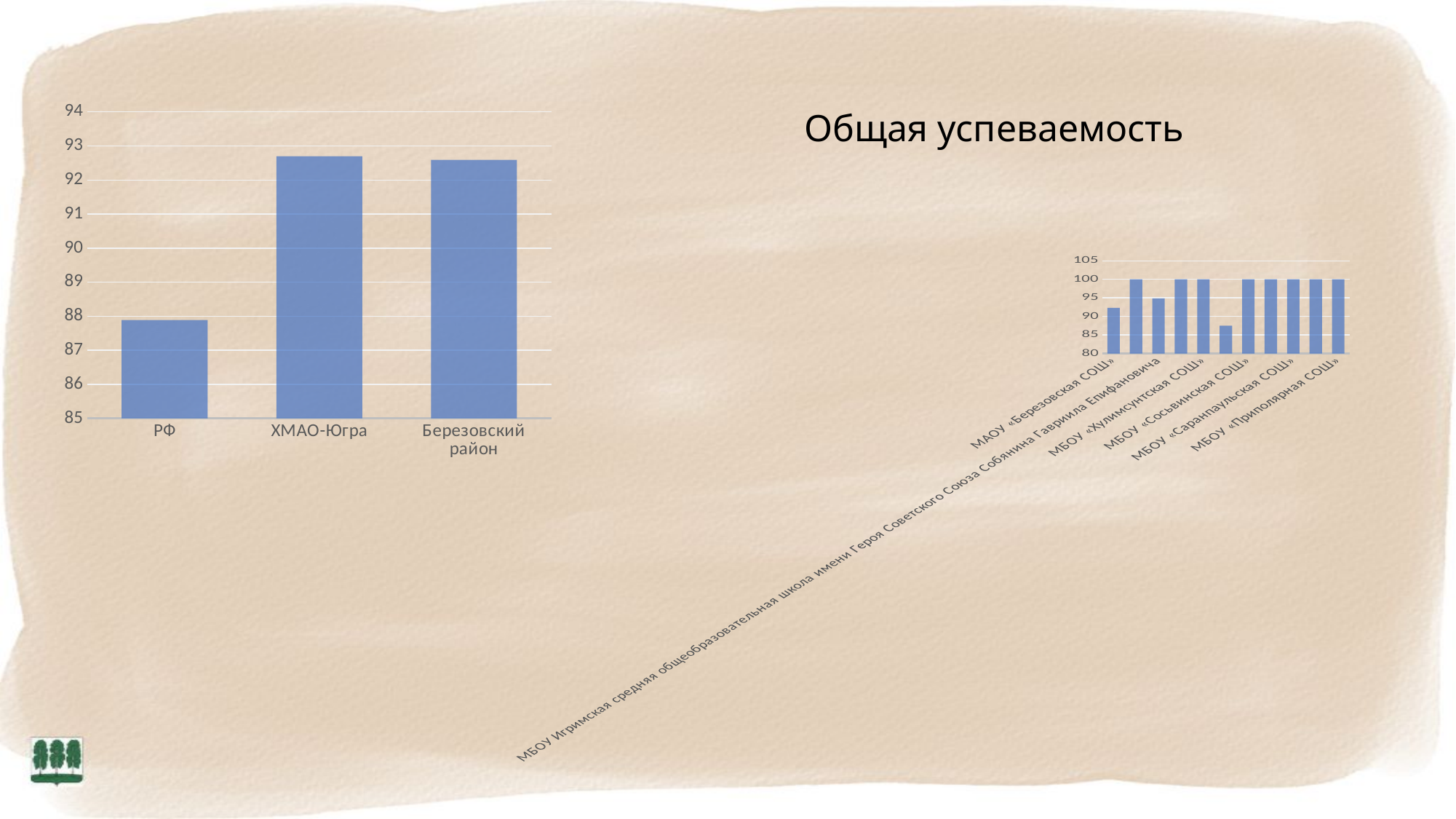
On the left chart, is the value for ХМАО-Югра greater or less than 92? greater How many bars are shown on the chart on the right of the slide? 11 On the left chart, which is larger: the value for РФ or the value for ХМАО-Югра? ХМАО-Югра On the right chart, is the value for МАОУ «Березовская СОШ» greater or less than 95? less On the left chart, is the value for Березовский район greater or less than 92? greater What kind of chart is the chart on the left of the slide? bar chart On the left chart, which is larger: the value for РФ or the value for Березовский район? Березовский район How many categories are shown on the left chart? 3 On the left chart, which category has the lowest value? РФ What is the title shown on the slide above the right chart? Общая успеваемость